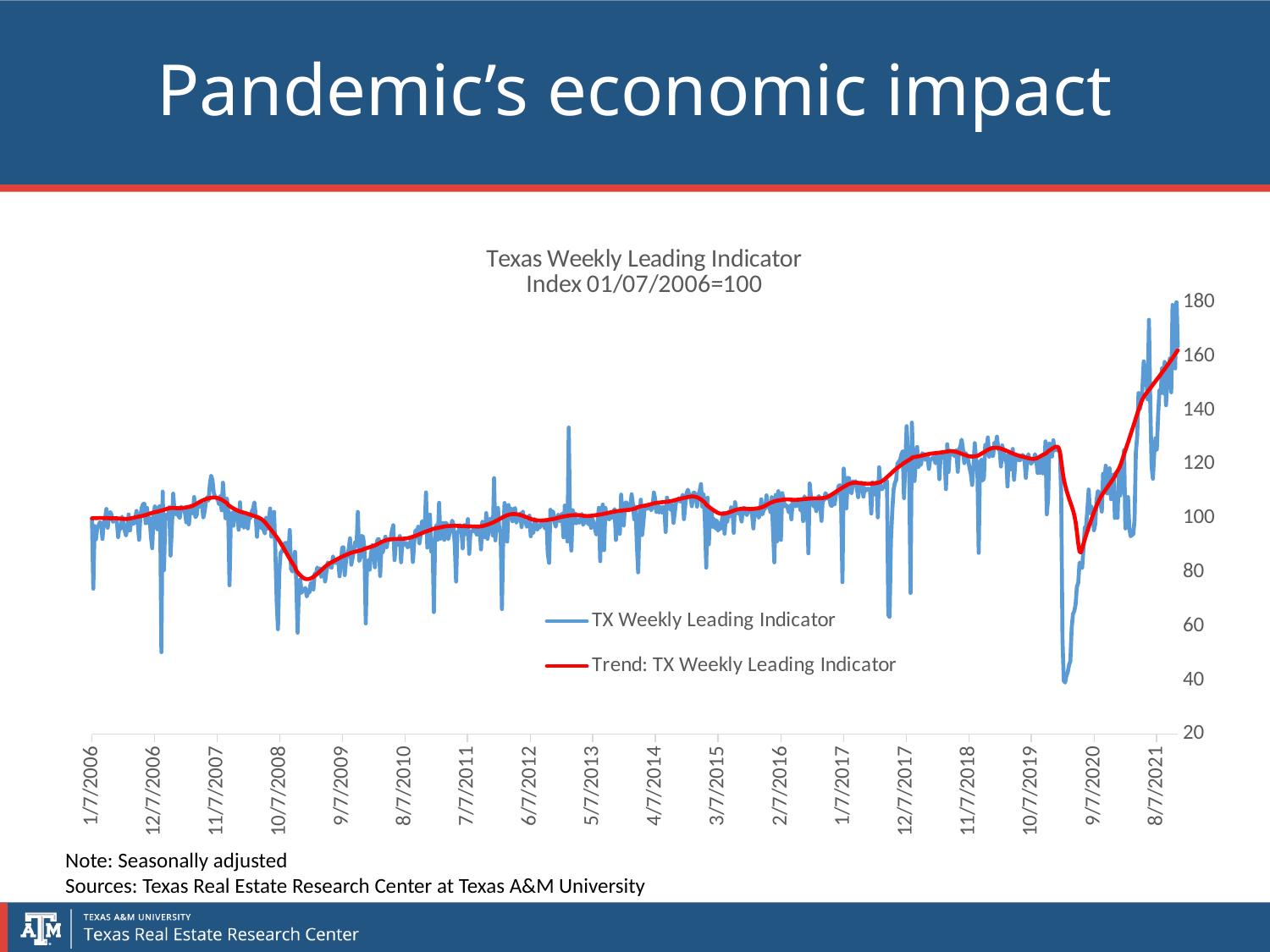
Overall, does the Trend: TX Weekly Leading Indicator series rise or fall from 1/7/2006 to 8/7/2021? Rise Is the value of the Trend: TX Weekly Leading Indicator series at 9/7/2009 greater or less than 100? less Which colour is used for the Trend: TX Weekly Leading Indicator series? Red How many date labels are shown on the x axis? 18 Is the value of the Trend: TX Weekly Leading Indicator series at 8/7/2021 greater or less than 140? greater Is the highest peak of the TX Weekly Leading Indicator series greater or less than 160? greater What kind of chart is shown on the slide? Line chart What is the index value of the Texas Weekly Leading Indicator on 01/07/2006, according to the chart title? 100 Which series reaches the higher peak value on the chart, TX Weekly Leading Indicator or Trend: TX Weekly Leading Indicator? TX Weekly Leading Indicator How many series does the chart legend list? 2 What is the title of the chart? Texas Weekly Leading Indicator Index 01/07/2006=100